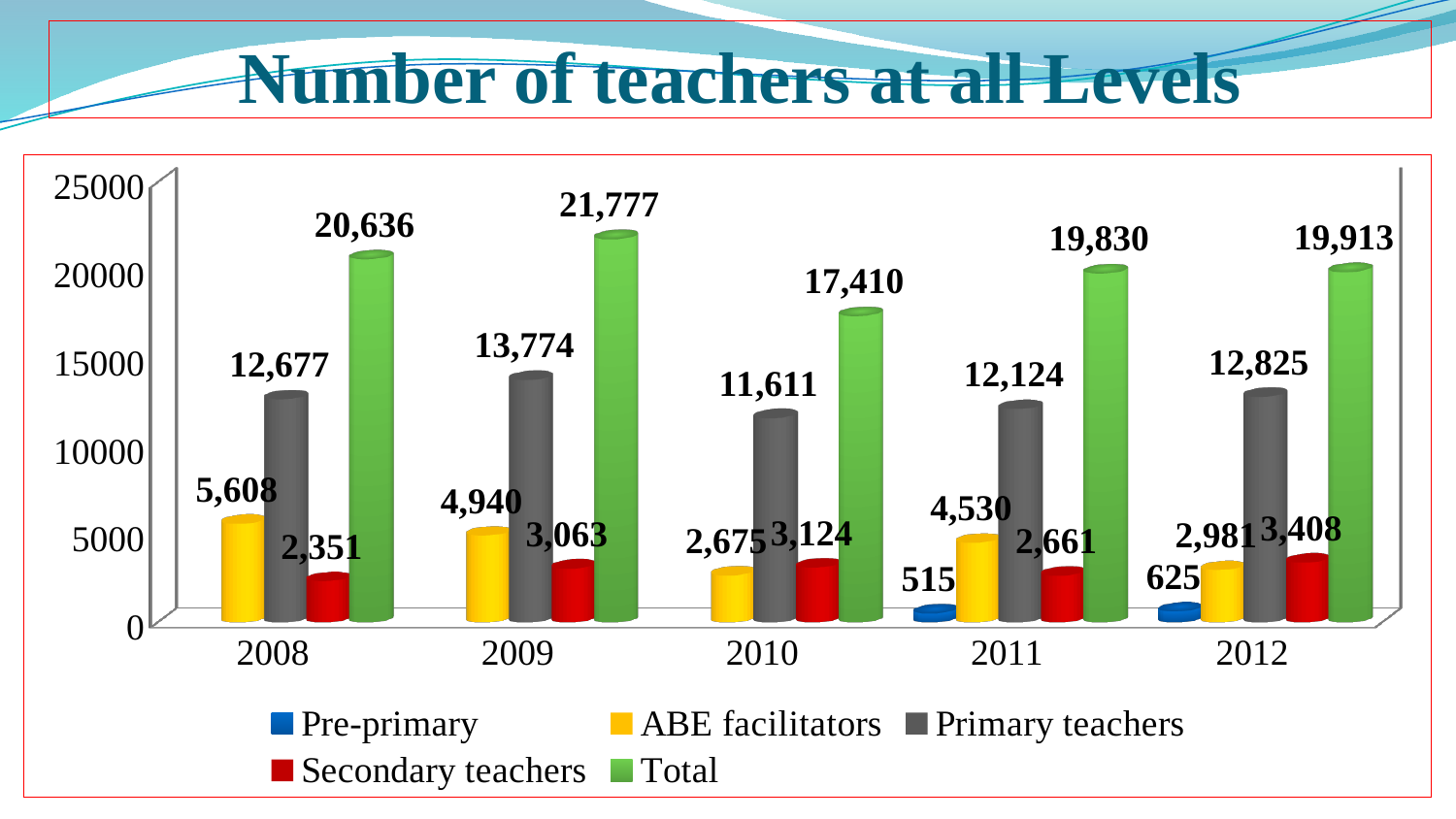
How many Primary teachers were there in 2011? 12,124 What is the Total number of teachers in 2009? 21,777 Which year has the lowest Total? 2010 What is the title of the chart? Number of teachers at all Levels Is the value for Primary teachers in 2010 greater or less than 10000? greater What is the difference between the Total in 2012 and the Total in 2011? 83 How many years are shown on the x axis? 5 What is the value for Pre-primary in 2012? 625 What kind of chart is shown on the slide? Bar chart Which is larger: ABE facilitators in 2008 or ABE facilitators in 2009? ABE facilitators in 2008 How many series does the legend list? 5 Which year has the highest Total? 2009